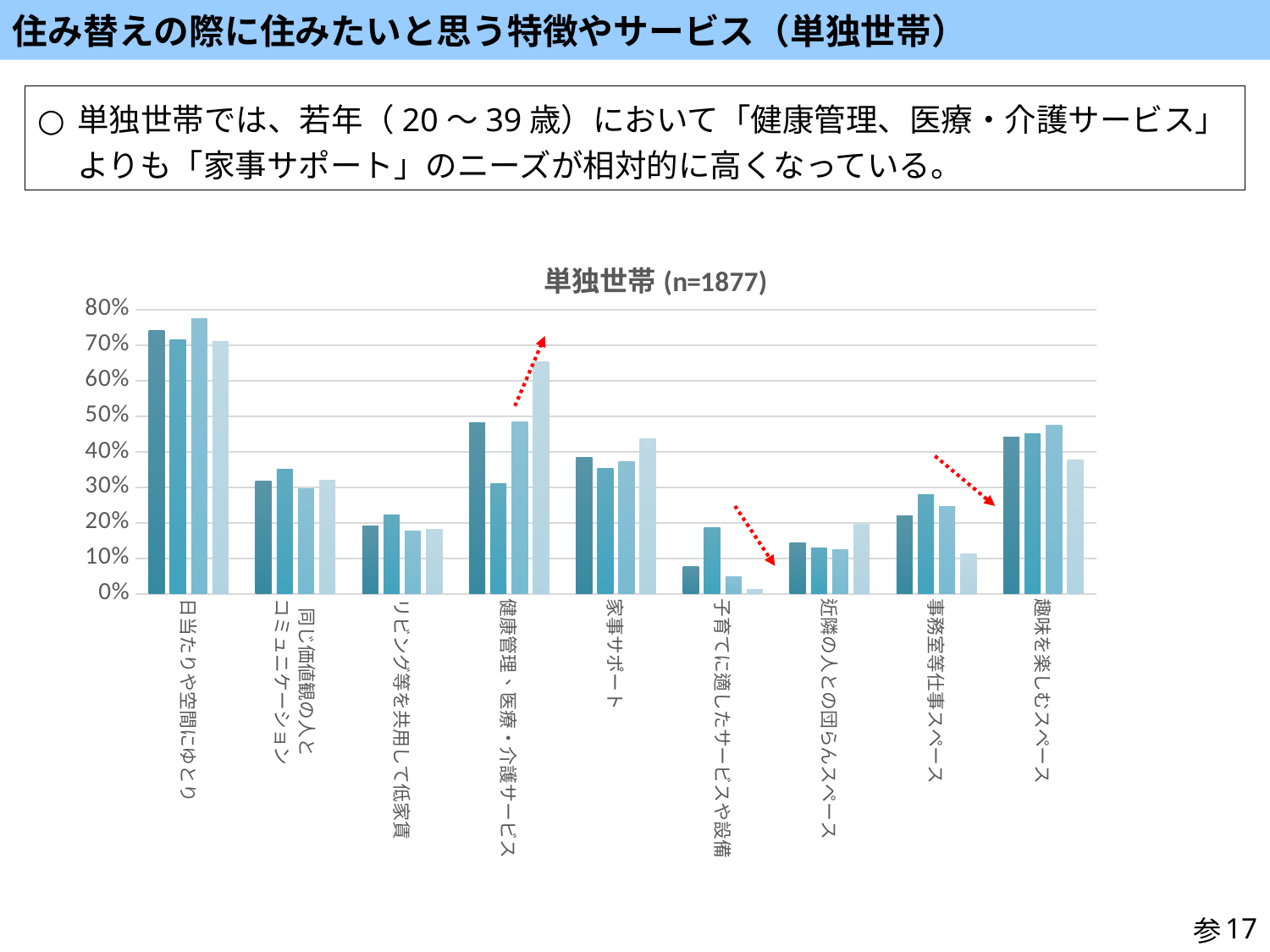
Is the tallest bar for リビング等を共用して低家賃 greater or less than 30%? less What sample size (n) is given in the chart title? 1877 What kind of chart is shown on the slide? bar chart Is the tallest bar for 健康管理、医療・介護サービス greater or less than 60%? greater Is the tallest bar for 日当たりや空間にゆとり greater or less than 70%? greater Which category has higher bars overall: 家事サポート or 近隣の人との団らんスペース? 家事サポート Which category has the lowest bars in the chart? 子育てに適したサービスや設備 Which category has higher bars overall: 趣味を楽しむスペース or 事務室等仕事スペース? 趣味を楽しむスペース How many categories are shown along the x axis of the chart? 9 Which category has the tallest bars in the chart? 日当たりや空間にゆとり What is the title of the chart? 単独世帯 (n=1877)